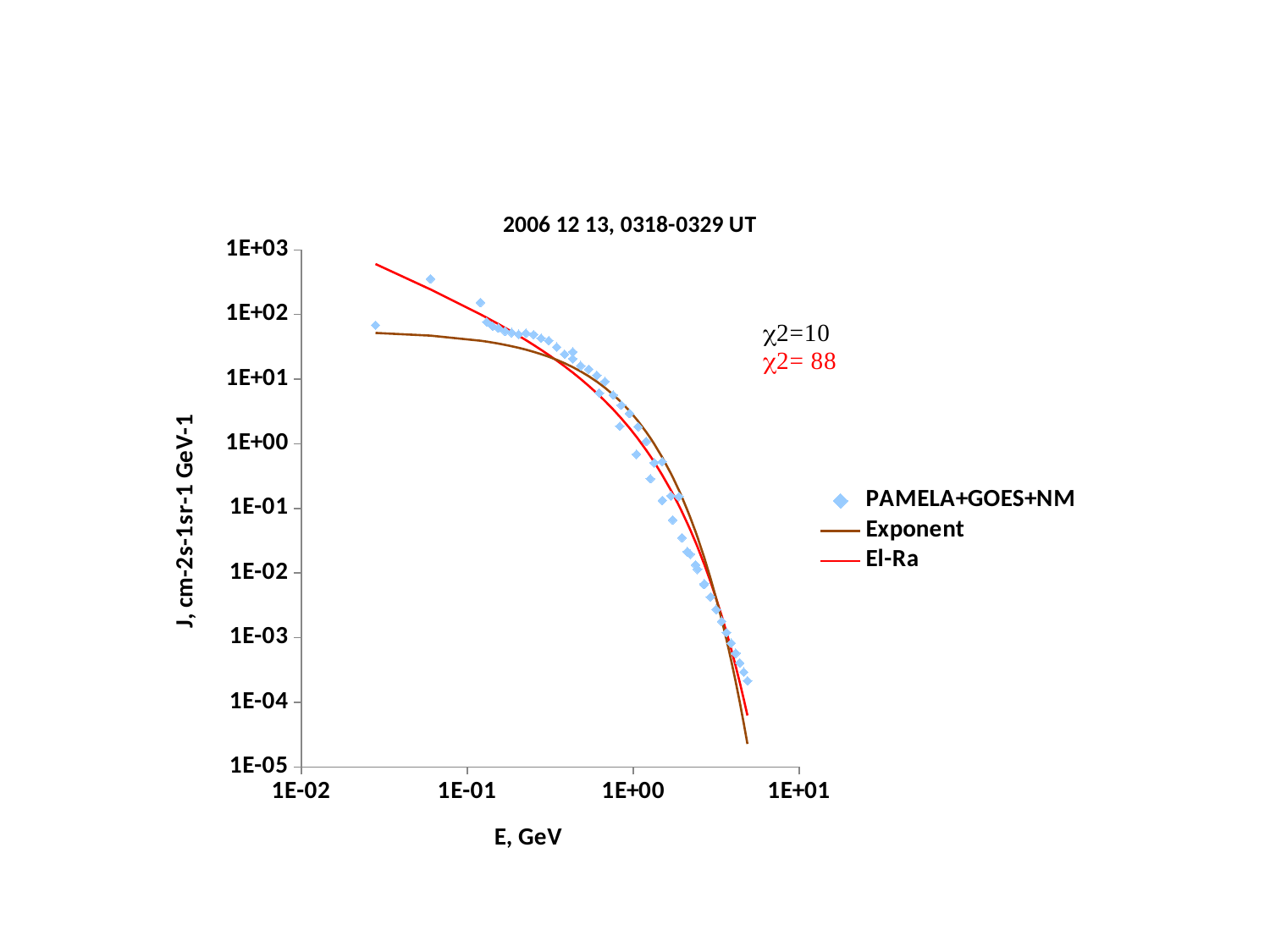
What χ2 value is given for the Exponent fit? 10 What is the title of the chart? 2006 12 13, 0318-0329 UT What kind of chart is shown on the slide? Scatter chart with fitted lines How many series does the legend list? 3 What is the label of the x axis? E, GeV What is the difference between the χ2 values of the El-Ra and Exponent fits? 78 What is the lowest value shown on the y axis? 1E-05 Do the PAMELA+GOES+NM values rise or fall as E increases along the x axis? Fall What χ2 value is given for the El-Ra fit? 88 Is the highest PAMELA+GOES+NM data point greater or less than 1E+02? greater Which fit has the lower χ2 value, Exponent or El-Ra? Exponent Is the lowest PAMELA+GOES+NM data point greater or less than 1E-03? less